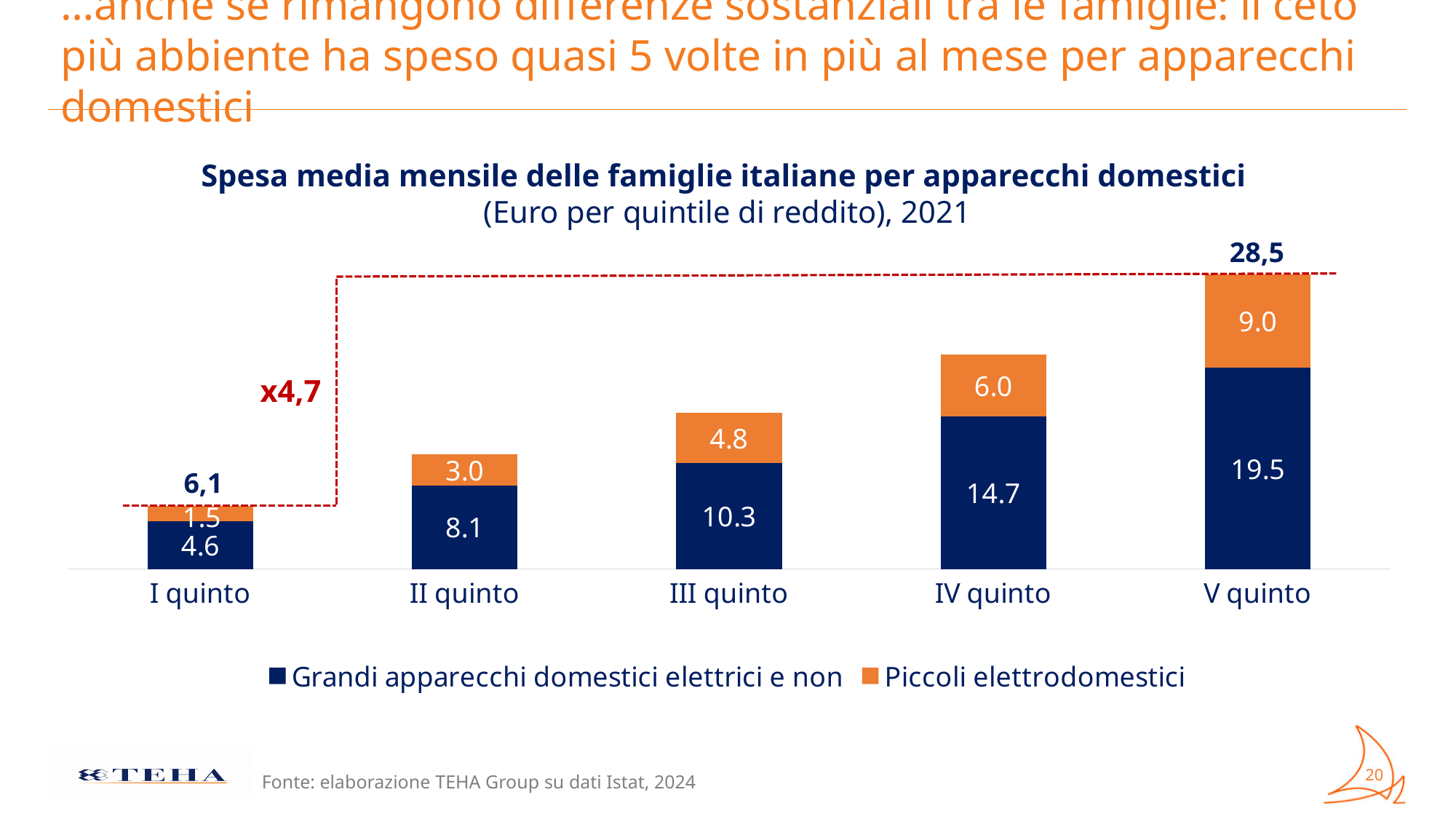
Which is larger: the Piccoli elettrodomestici value for II quinto or for III quinto? III quinto What is the total of the stacked bar for V quinto? 28,5 What is the value for Piccoli elettrodomestici in the I quinto bar? 1.5 How many quintile categories are shown on the x axis? 5 Which quintile has the lowest value for Piccoli elettrodomestici? I quinto What is the total of the stacked bar for II quinto? 11.1 What is the value for Piccoli elettrodomestici in the IV quinto bar? 6.0 How many series does the legend list? 2 Which quintile has the highest value for Grandi apparecchi domestici elettrici e non? V quinto What is the value for Grandi apparecchi domestici elettrici e non in the III quinto bar? 10.3 What is the difference between the Grandi apparecchi domestici elettrici e non values for V quinto and IV quinto? 4.8 What kind of chart is shown on the slide? Stacked bar chart